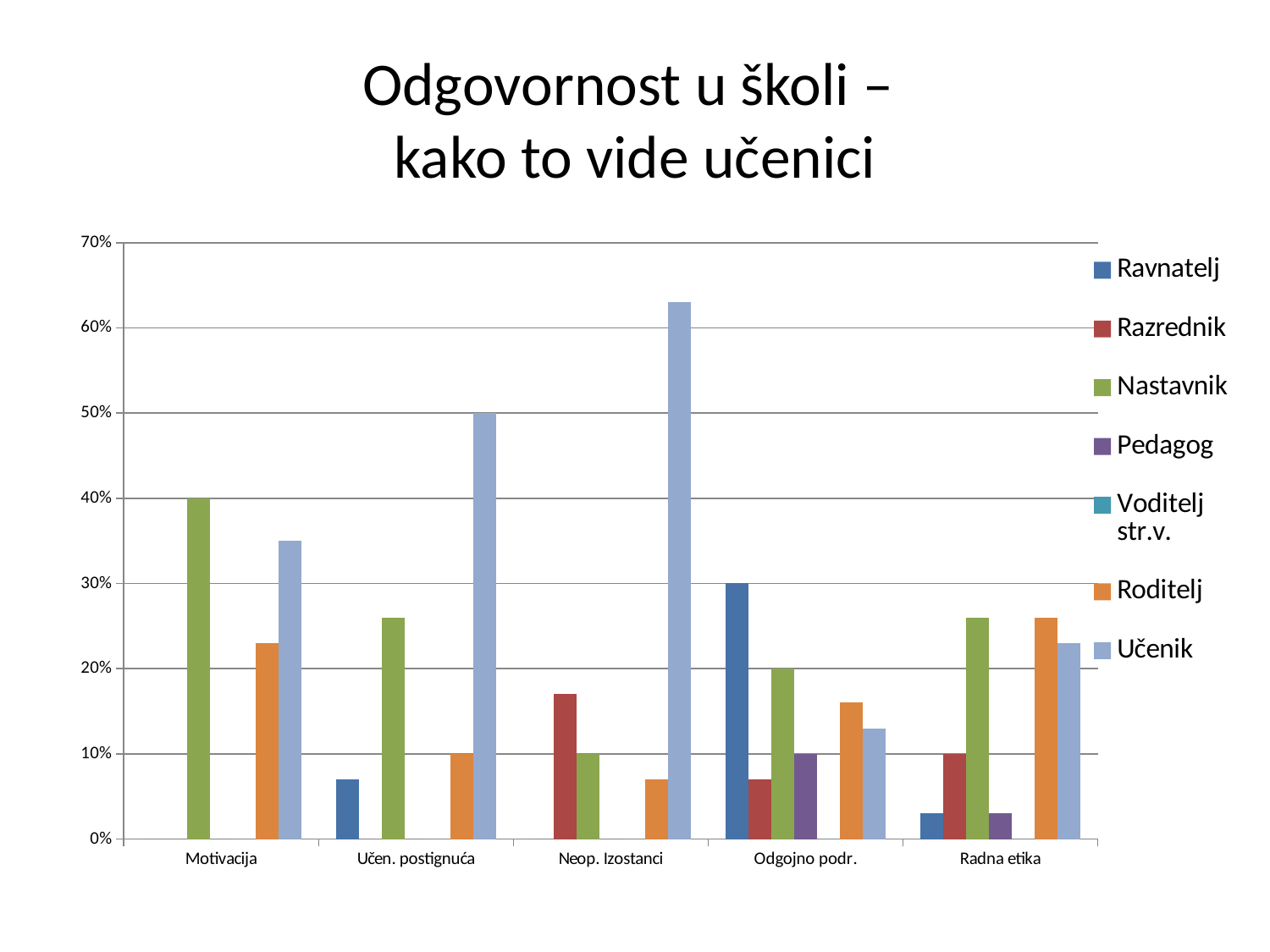
What is the title of the slide? Odgovornost u školi – kako to vide učenici Is the value for Roditelj in the Odgojno podr. category greater or less than 20%? less Is the value for Učenik in the Neop. Izostanci category greater or less than 60%? greater Which category has the tallest bar in the whole chart? Neop. Izostanci Which series has the tallest bar in the Odgojno podr. category? Ravnatelj How many categories are shown on the x axis? 5 What kind of chart is shown on the slide? bar chart Is the value for Učenik in the Motivacija category greater or less than 30%? greater Which series has the tallest bar in the Neop. Izostanci category? Učenik How many series does the legend list? 7 Which is larger: the Učenik value for Učen. postignuća or the Učenik value for Motivacija? Učen. postignuća